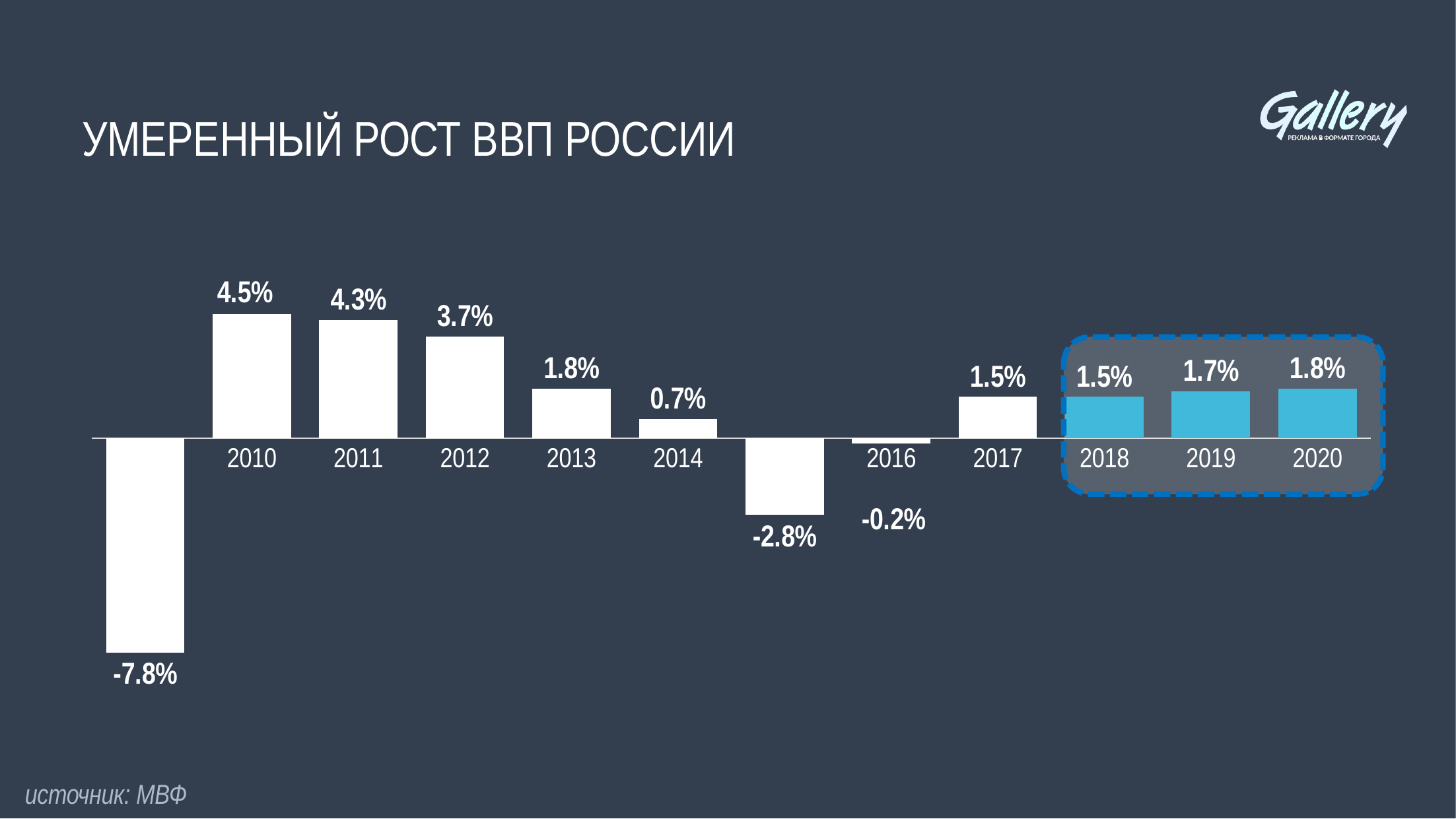
Do the values rise or fall from 2018 to 2020? rise What is the title of the chart? УМЕРЕННЫЙ РОСТ ВВП РОССИИ What is the value for 2014? 0.7% What is the difference between the values for 2011 and 2012? 0.6% Which is larger, the value for 2013 or the value for 2017? 2013 What is the value for 2020? 1.8% What kind of chart is shown on the slide? bar chart Which labelled year has the highest value? 2010 What is the value for 2010? 4.5% What is the value for 2016? -0.2% How many bars are plotted on the chart? 12 What is the lowest value shown on the chart? -7.8%